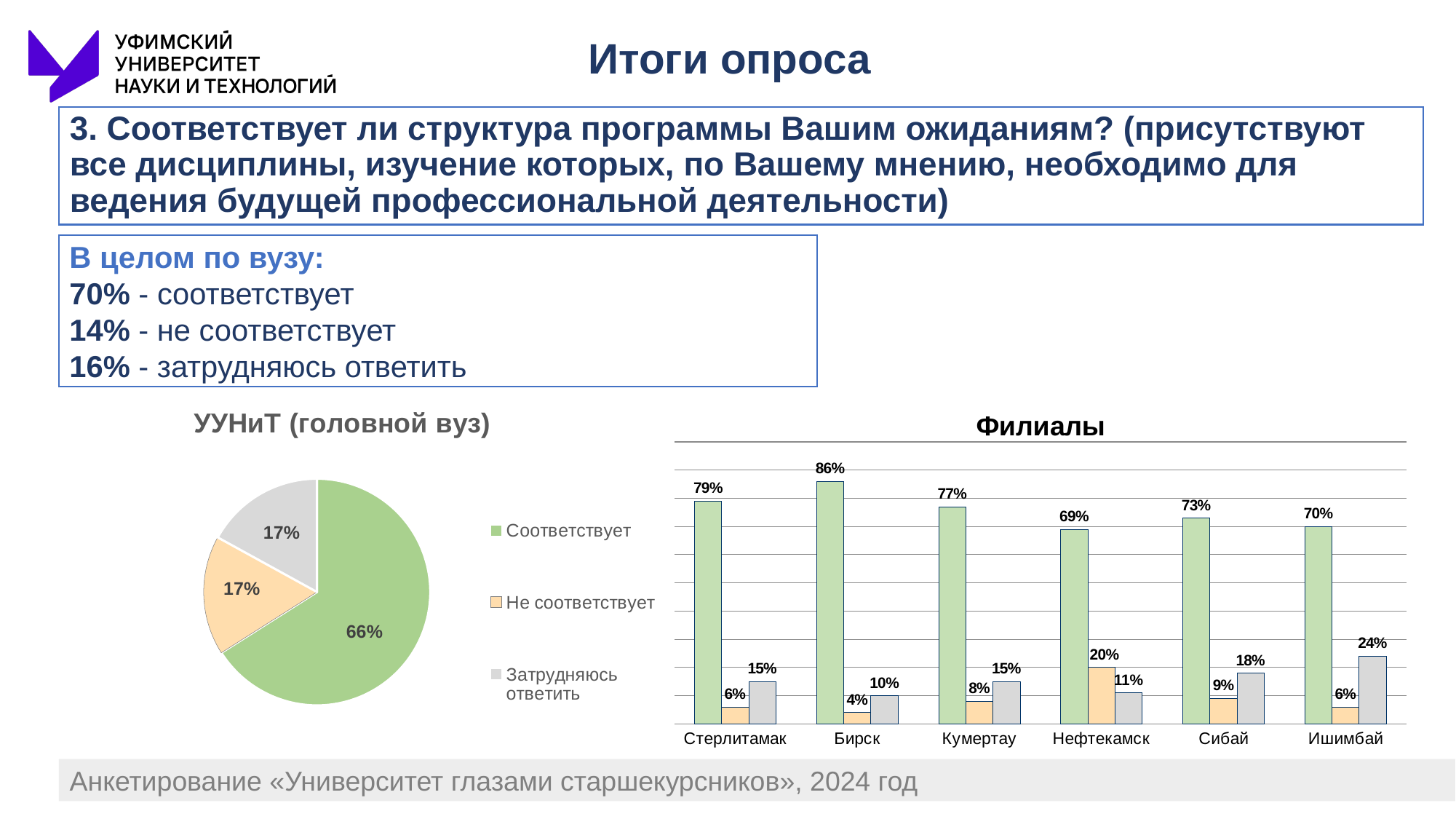
What type of chart is the 'УУНиТ (головной вуз)' chart? pie chart How many entries does the legend of the 'УУНиТ (головной вуз)' pie chart list? 3 In the 'Филиалы' chart, what is the value of the green bar for Бирск? 86% In the 'Филиалы' chart, what is the difference between the green bars for Стерлитамак and Кумертау? 2% In the 'Филиалы' chart, which branch has the lowest green bar? Нефтекамск In the 'Филиалы' chart, which is larger: the grey bar for Ишимбай or the grey bar for Сибай? Ишимбай How many branches (categories) are shown on the x axis of the 'Филиалы' chart? 6 In the pie chart 'УУНиТ (головной вуз)', what is the value for 'Не соответствует'? 17% In the 'Филиалы' chart, which branch has the highest green bar? Бирск In the 'Филиалы' chart, what is the value of the orange bar for Нефтекамск? 20% What type of chart is the 'Филиалы' chart? bar chart In the pie chart 'УУНиТ (головной вуз)', what share of respondents answered 'Соответствует'? 66%